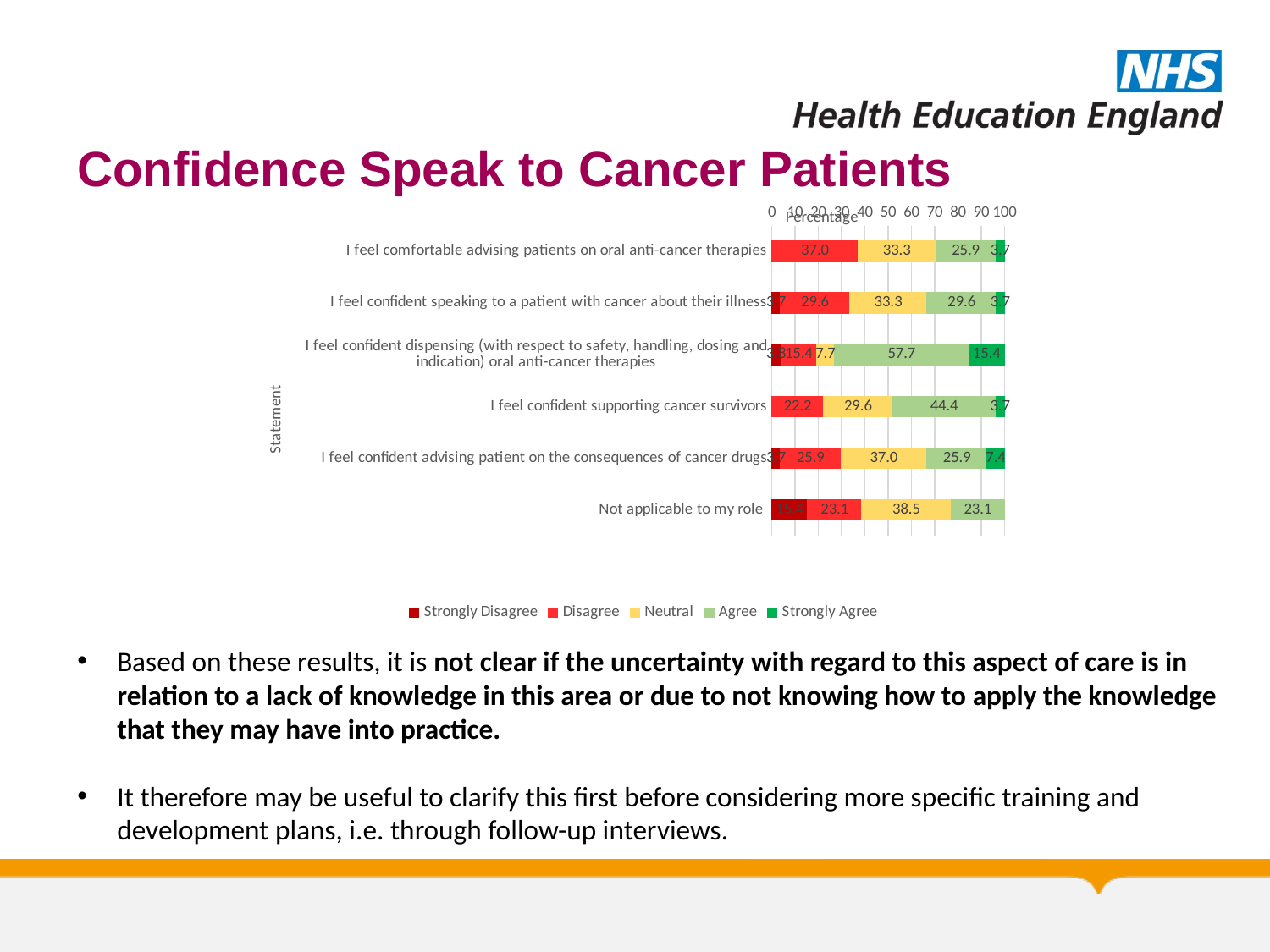
What kind of chart is shown on the slide? Stacked bar chart Which is larger: the Agree value for "I feel confident supporting cancer survivors" or the Agree value for "I feel comfortable advising patients on oral anti-cancer therapies"? I feel confident supporting cancer survivors How many statements (categories) are shown on the chart? 6 What is the Agree value for "I feel confident dispensing (with respect to safety, handling, dosing and indication) oral anti-cancer therapies"? 57.7 What is the Disagree value for "I feel comfortable advising patients on oral anti-cancer therapies"? 37.0 Which statement has the highest Agree value? I feel confident dispensing (with respect to safety, handling, dosing and indication) oral anti-cancer therapies What is the title of the horizontal axis of the chart? Percentage How many series does the legend list? 5 For "I feel comfortable advising patients on oral anti-cancer therapies", what is the difference between the Disagree value and the Agree value? 11.1 What is the Agree value for "I feel confident supporting cancer survivors"? 44.4 What is the Neutral value for "Not applicable to my role"? 38.5 What is the Neutral value for "I feel confident advising patient on the consequences of cancer drugs"? 37.0